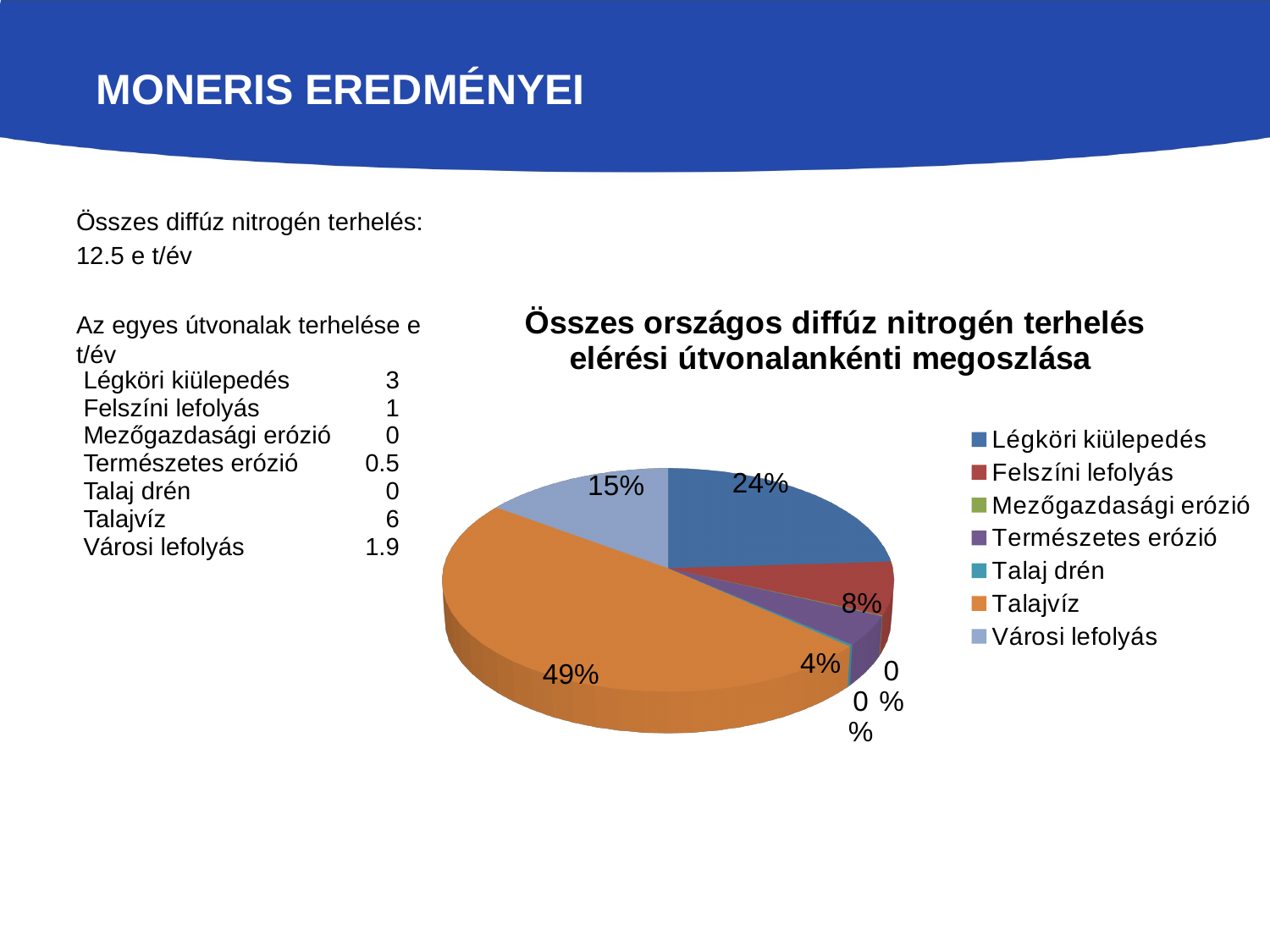
Which slice is larger, Városi lefolyás or Felszíni lefolyás? Városi lefolyás How many categories does the pie chart's legend list? 7 What share of the pie does Felszíni lefolyás represent? 8% What colour is the Talajvíz slice in the pie chart? orange What share of the pie does Talajvíz represent? 49% Which category has the largest slice of the pie? Talajvíz What share of the pie does Természetes erózió represent? 4% What is the title of the pie chart? Összes országos diffúz nitrogén terhelés elérési útvonalankénti megoszlása What kind of chart is shown on the slide? pie chart What is the difference in percentage points between the Talajvíz slice and the Légköri kiülepedés slice? 25